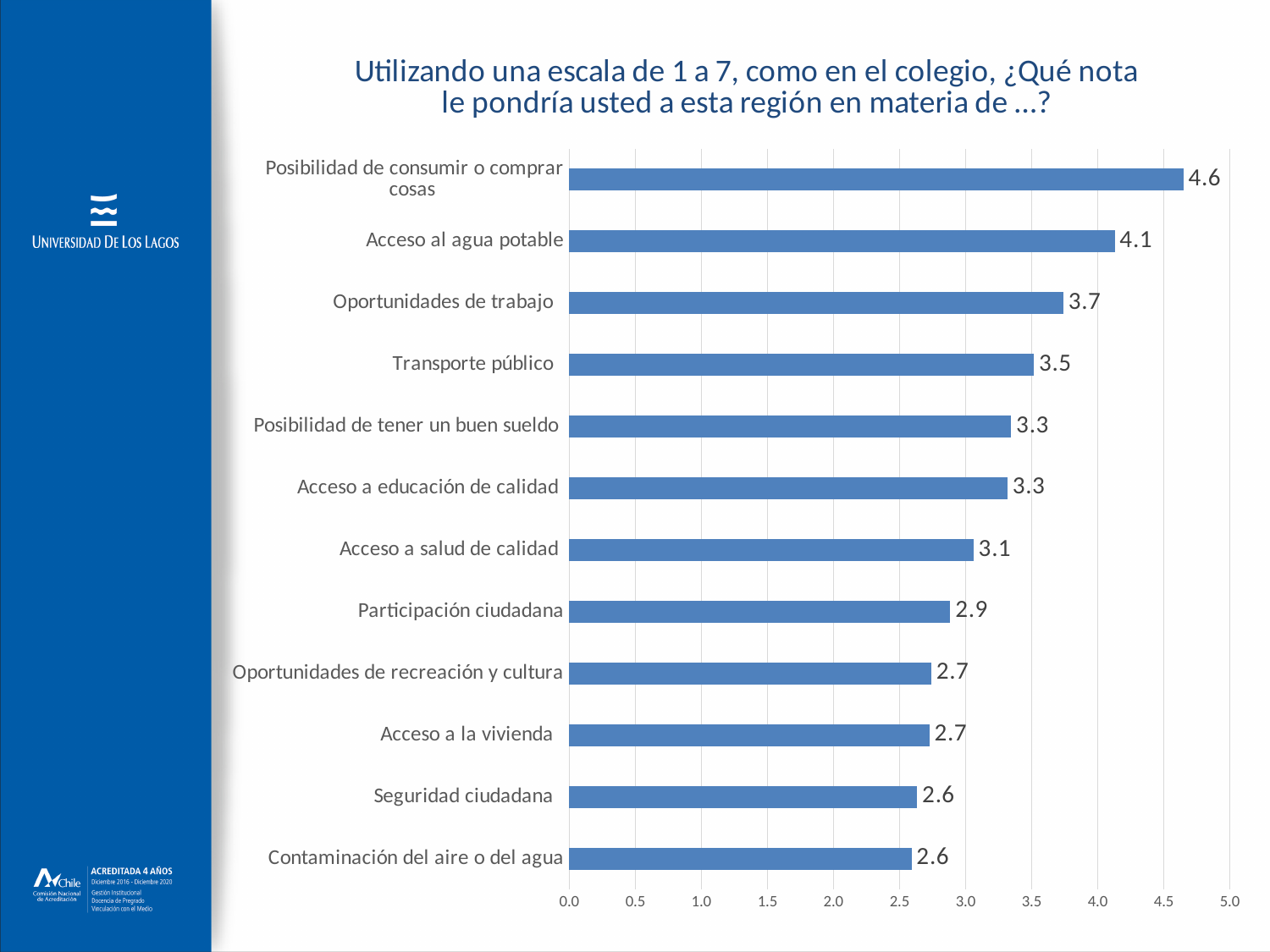
Which is larger, the value for Acceso a salud de calidad or the value for Acceso a la vivienda? Acceso a salud de calidad How many categories are shown in the chart? 12 What value is shown for Acceso al agua potable? 4.1 What is the difference between the values for Oportunidades de trabajo and Seguridad ciudadana? 1.1 What is the difference between the values for Posibilidad de consumir o comprar cosas and Acceso al agua potable? 0.5 Is the value for Oportunidades de trabajo greater or less than 3.5? greater What value is shown for Transporte público? 3.5 What value is shown for Participación ciudadana? 2.9 Which category has the highest value? Posibilidad de consumir o comprar cosas What is the maximum value shown on the horizontal axis? 5.0 What value is shown for Contaminación del aire o del agua? 2.6 What kind of chart is shown on the slide? bar chart